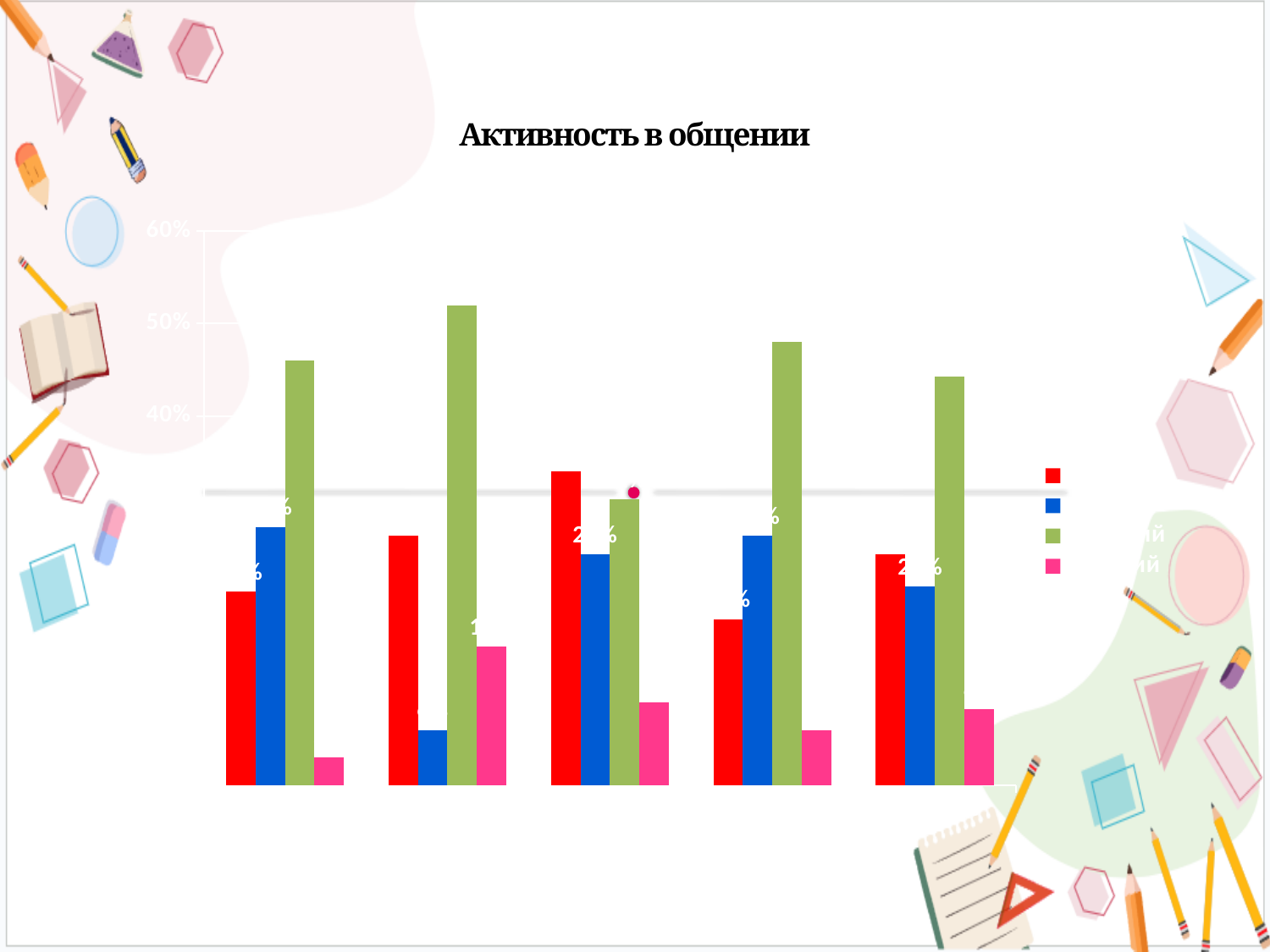
How many series does the legend list? 4 Is the value of the pink bar in the leftmost group greater or less than 40%? less Is the value of the green bar in the rightmost group greater or less than 50%? less Is the value of the green bar in the middle (third) group greater or less than 40%? less What is the title of the chart? Активность в общении How many groups of bars are plotted along the x axis? 5 What kind of chart is shown on the slide? bar chart Among the green bars, which group has the lowest value: the second group from the left or the third group from the left? the third group from the left